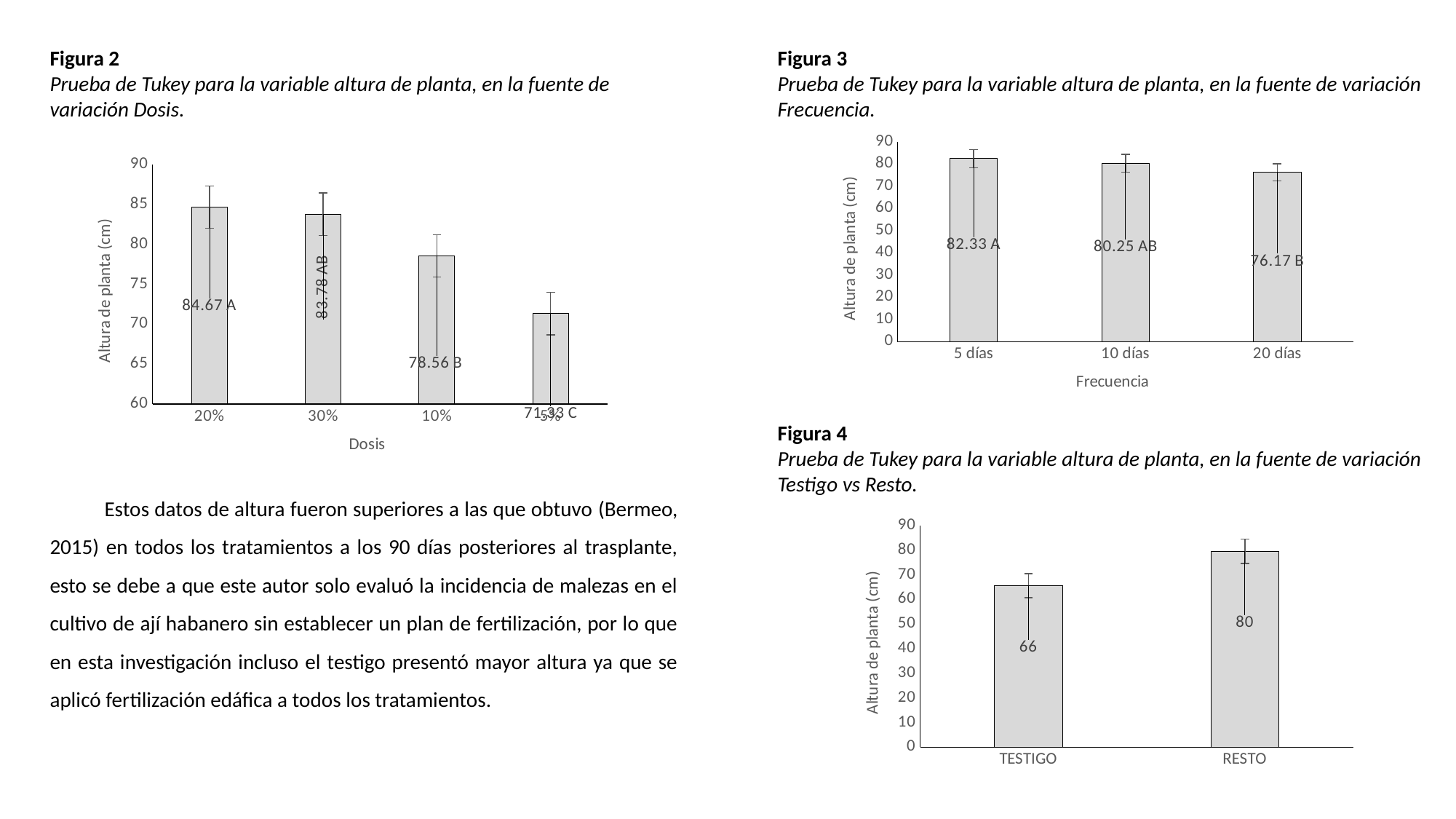
In Figura 4 (Testigo vs Resto), what is the difference between the RESTO and TESTIGO values? 14 In Figura 3 (Frecuencia), which frequency has the lowest plant height? 20 días In Figura 4 (Testigo vs Resto), which is larger, TESTIGO or RESTO? RESTO What kind of chart is Figura 4 (Testigo vs Resto)? bar chart In Figura 2 (Dosis), what is the data label for the 20% dose bar? 84.67 A In Figura 3 (Frecuencia), do the values rise or fall as frequency goes from 5 días to 20 días? fall In Figura 2 (Dosis), what is the data label for the 10% dose bar? 78.56 B In Figura 2 (Dosis), which dose has the highest plant height? 20% In Figura 2 (Dosis), how many dose categories are shown on the x axis? 4 In Figura 3 (Frecuencia), what is the difference between the plant height for 5 días and for 20 días? 6.16 In Figura 3 (Frecuencia), what is the plant height value for 10 días? 80.25 AB In Figura 4 (Testigo vs Resto), what is the plant height value for TESTIGO? 66